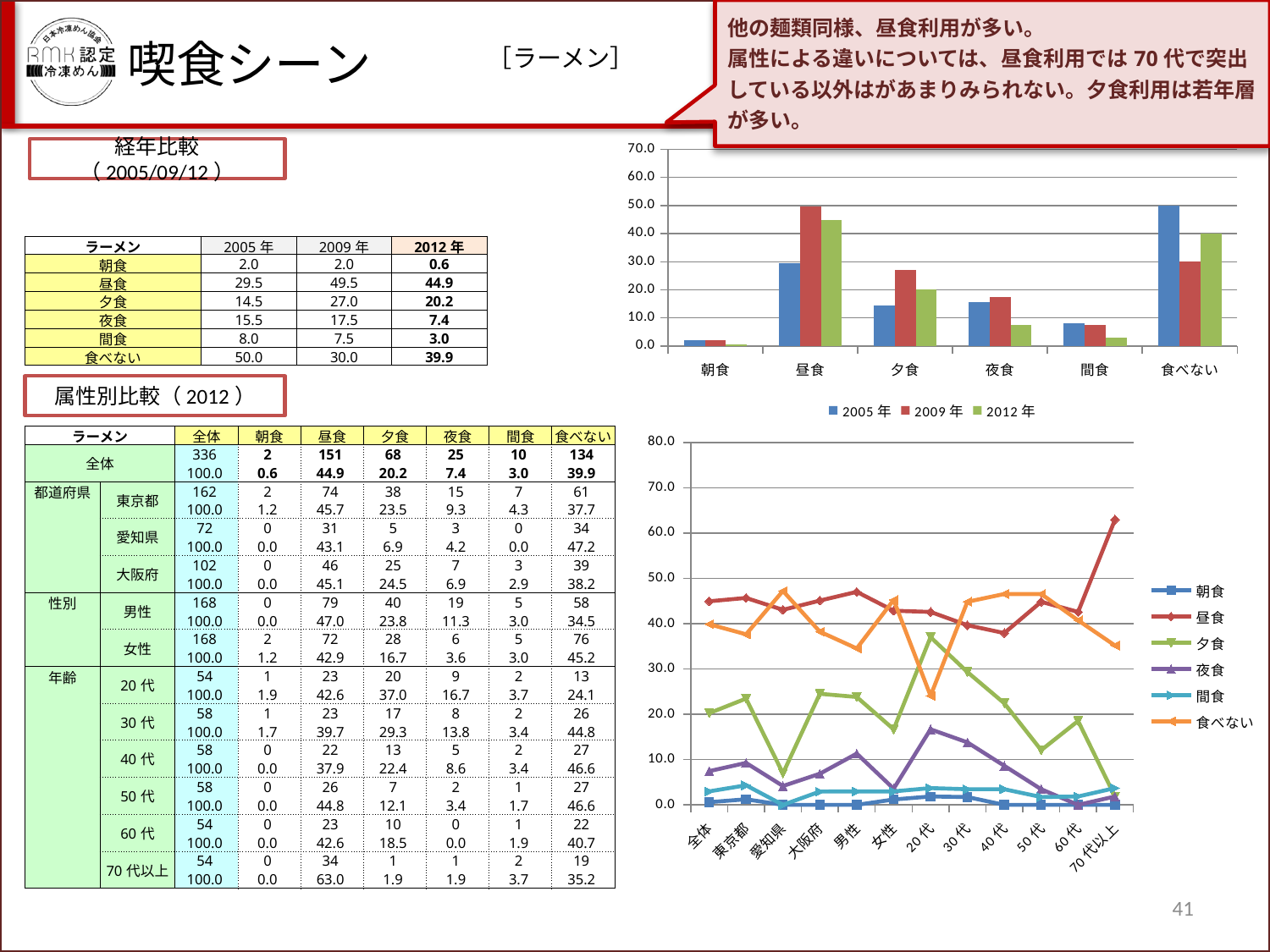
What kind of chart is the top-right chart comparing 2005年, 2009年 and 2012年? bar chart In the bottom-right line chart, how many series does the legend list? 6 In the top-right bar chart, is the value for 食べない in 2005年 greater or less than 40? greater In the top-right bar chart, what is the value for 昼食 in 2012年? 44.9 In the top-right bar chart, what is the difference between the 昼食 values for 2009年 and 2005年? 20.0 What kind of chart is the bottom-right chart showing 全体, 東京都, 愛知県 and other attributes? line chart In the top-right bar chart, how many series does the legend list? 3 In the bottom-right line chart, is the 夕食 value for 20代 greater or less than 30? greater In the top-right bar chart, which category has the highest value for 2009年? 昼食 In the bottom-right line chart, at which category does the 昼食 line reach its highest value? 70代以上 In the top-right bar chart, which is larger for 夕食: the 2009年 value or the 2012年 value? 2009年 In the top-right bar chart, how many categories are shown on the x axis? 6